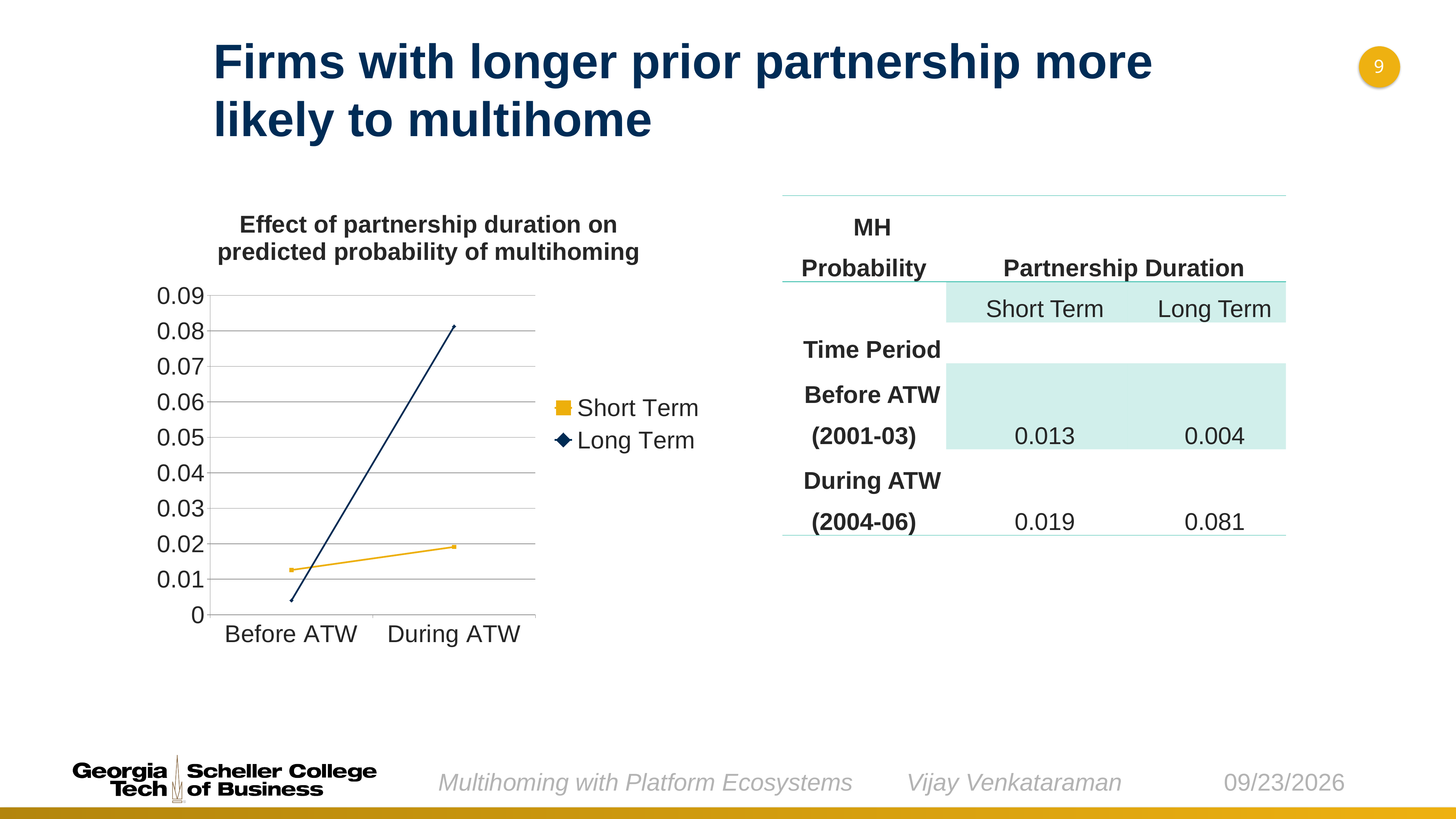
What is the difference between the Long Term and Short Term values During ATW? 0.062 What is the predicted probability of multihoming for Long Term partnerships During ATW? 0.081 Which series has the higher value Before ATW, Short Term or Long Term? Short Term What kind of chart is shown on the slide? line chart Does the Long Term series rise or fall from Before ATW to During ATW? rise Which series has the higher value During ATW, Short Term or Long Term? Long Term Which series is drawn in dark blue in the chart? Long Term What is the predicted probability of multihoming for Short Term partnerships Before ATW? 0.013 How many series does the chart legend list? 2 What is the predicted probability of multihoming for Long Term partnerships Before ATW? 0.004 What is the title of the chart? Effect of partnership duration on predicted probability of multihoming How many categories are shown on the x axis of the chart? 2